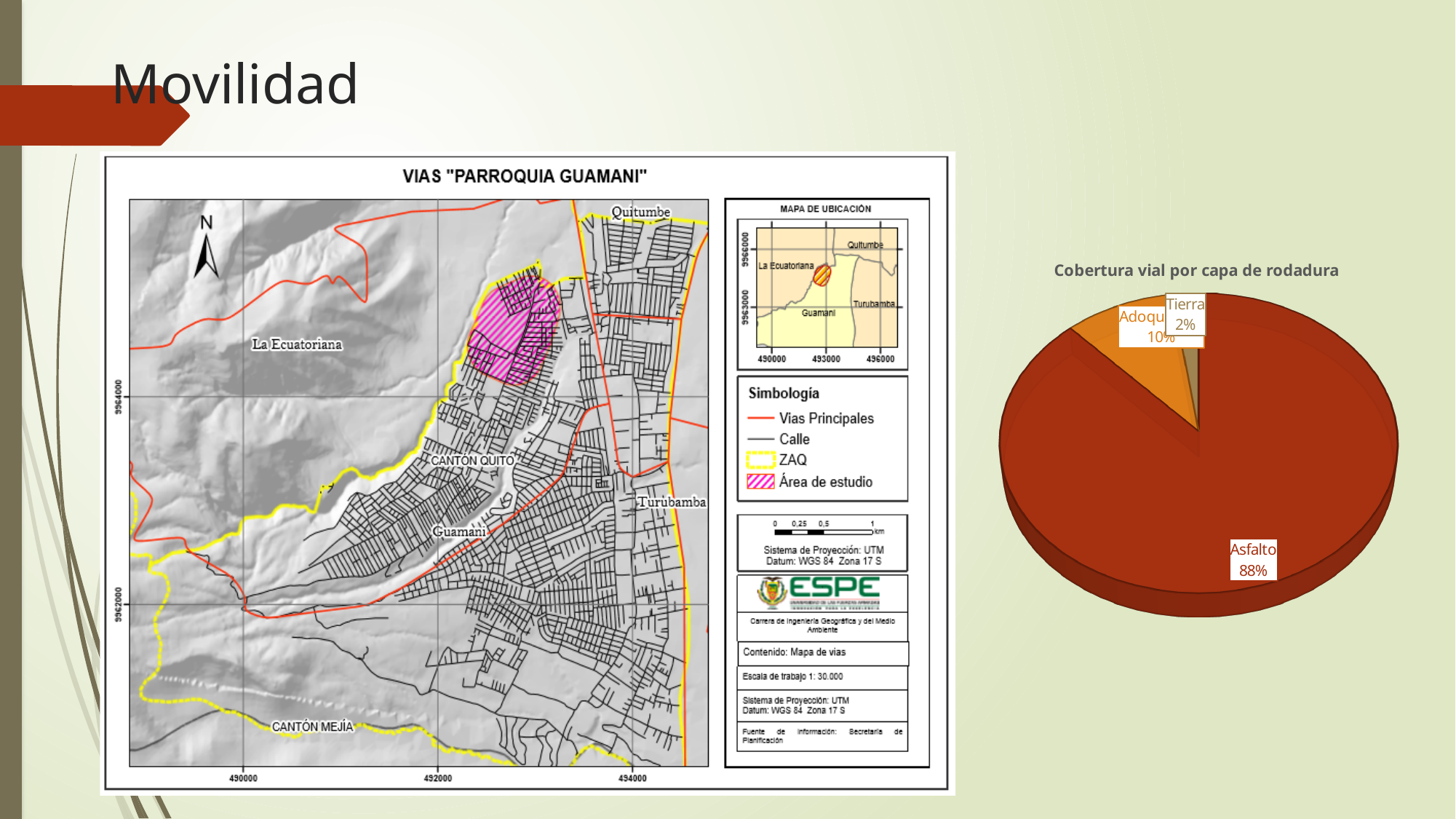
In the pie chart, what share do Adoquín and Tierra account for together? 12% Which category has the largest slice in the pie chart? Asfalto In the pie chart, what share does Adoquín have? 10% How many slices does the pie chart have? 3 In the pie chart, how many percentage points larger is Asfalto than Adoquín? 78% In the pie chart, is the share for Adoquín larger or smaller than the share for Tierra? larger Which category has the smallest slice in the pie chart? Tierra What kind of chart is shown on the right side of the slide? pie chart In the pie chart, what share does Asfalto have? 88% In the pie chart, how many percentage points larger is Asfalto than Tierra? 86% What is the title of the pie chart? Cobertura vial por capa de rodadura In the pie chart, what share does Tierra have? 2%